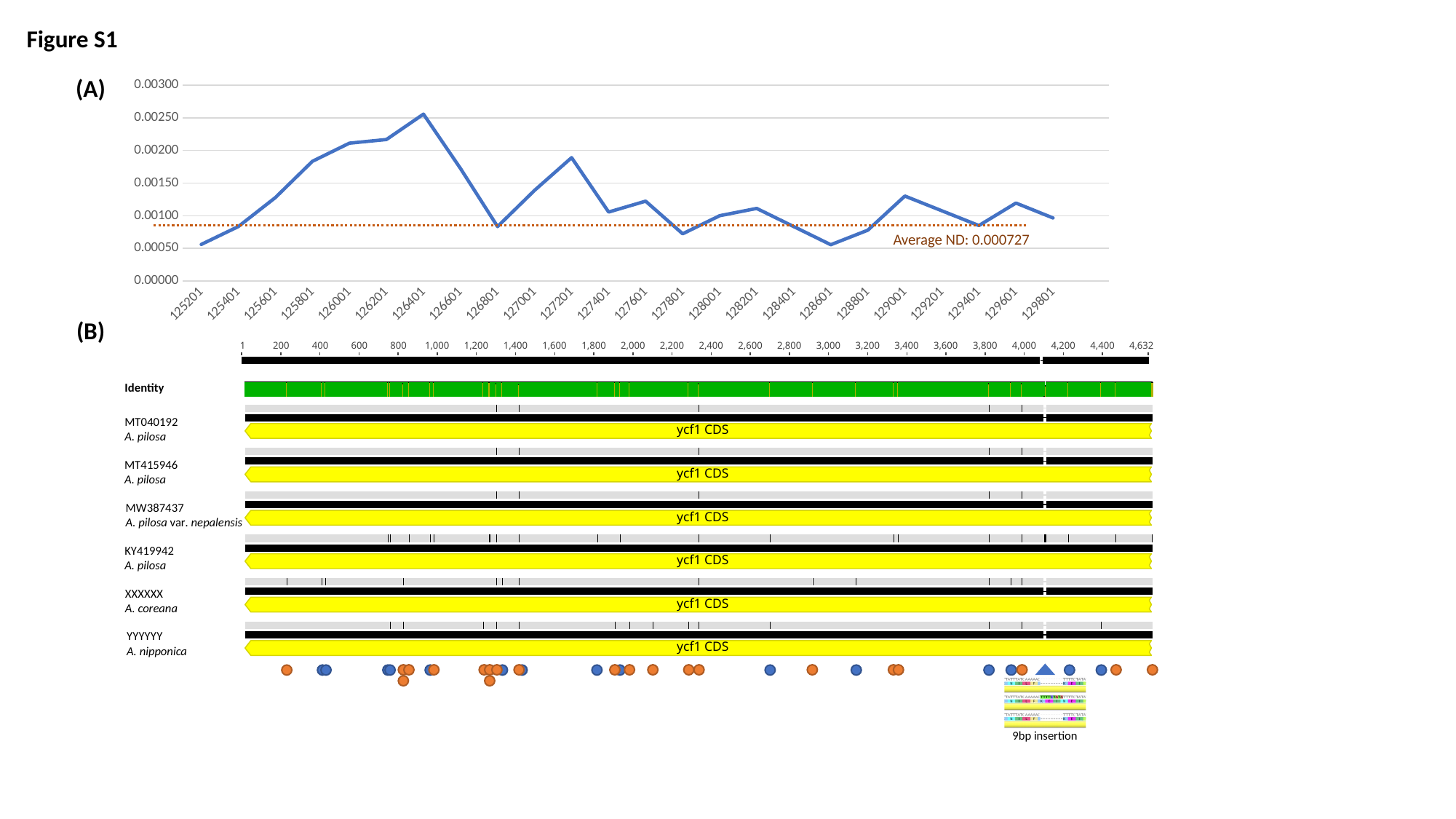
In panel (A), do the values rise or fall from 125201 to 126401? rise In panel (A), which has the larger value, 126401 or 127201? 126401 In panel (A), is the value at 126401 greater or less than 0.00200? greater In panel (A), is the value at 127201 greater or less than 0.00150? greater In panel (A), what colour is the dotted horizontal line marking the average ND? orange In panel (A), which has the larger value, 125201 or 126001? 126001 In panel (A), how many positions are labelled along the x axis? 24 In panel (A), is the value at 127801 greater or less than 0.00100? less In panel (A), at which x-axis position does the line reach its highest value? 126401 In panel (A), what is the average ND value printed on the chart? 0.000727 What kind of chart is panel (A)? line chart